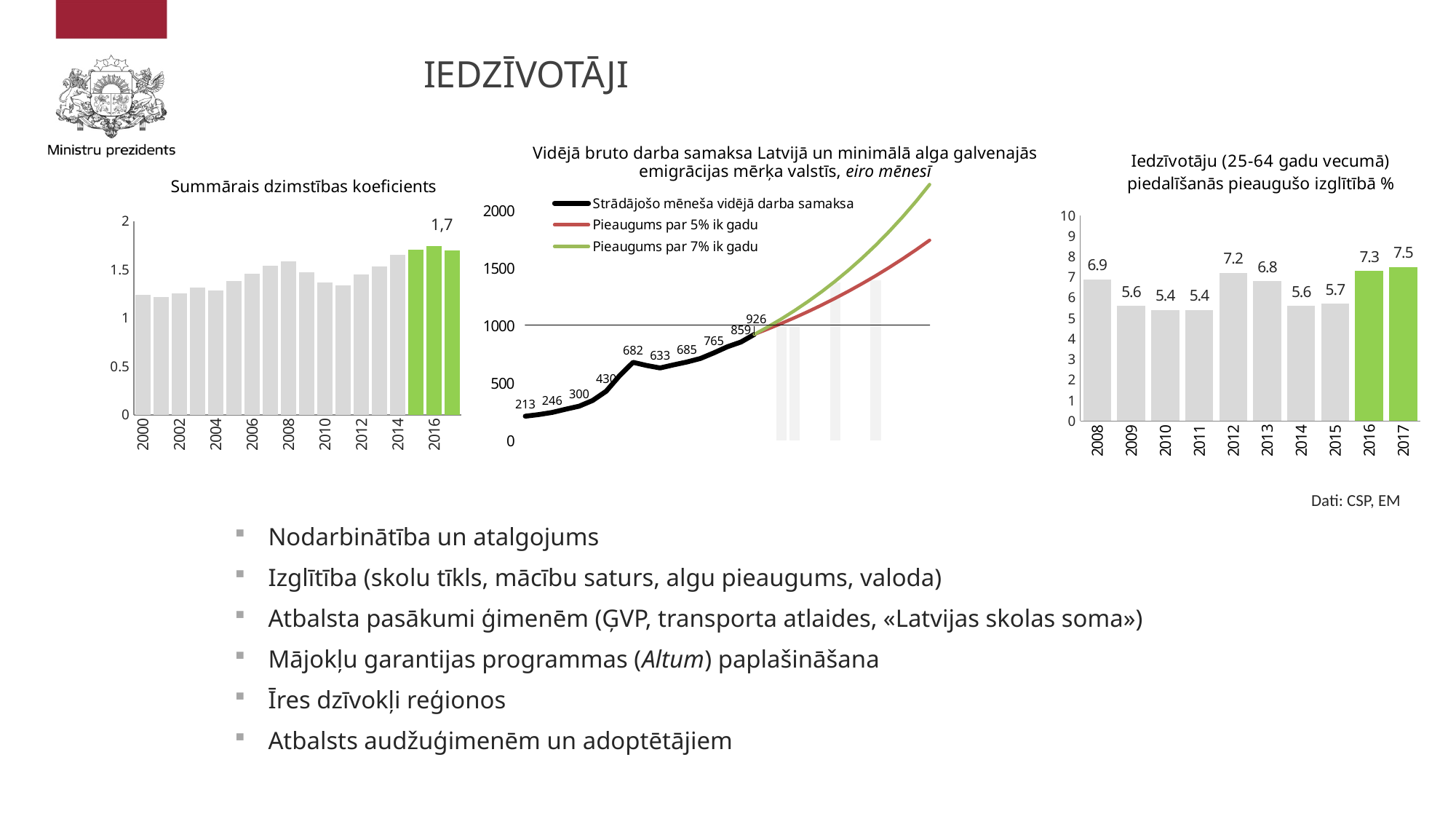
In the chart 'Iedzīvotāju (25-64 gadu vecumā) piedalīšanās pieaugušo izglītībā %', which year has the highest value? 2017 What kind of chart is 'Vidējā bruto darba samaksa Latvijā un minimālā alga galvenajās emigrācijas mērķa valstīs'? line chart In the chart 'Iedzīvotāju (25-64 gadu vecumā) piedalīšanās pieaugušo izglītībā %', what is the value for 2017? 7.5 How many series does the legend list in the chart 'Vidējā bruto darba samaksa Latvijā un minimālā alga galvenajās emigrācijas mērķa valstīs'? 3 In the chart 'Vidējā bruto darba samaksa Latvijā un minimālā alga galvenajās emigrācijas mērķa valstīs', what is the highest labelled value on the 'Strādājošo mēneša vidējā darba samaksa' line? 926 In the chart 'Iedzīvotāju (25-64 gadu vecumā) piedalīšanās pieaugušo izglītībā %', what is the value for 2008? 6.9 In the chart 'Iedzīvotāju (25-64 gadu vecumā) piedalīšanās pieaugušo izglītībā %', which is larger, the value for 2012 or for 2013? 2012 In the chart 'Iedzīvotāju (25-64 gadu vecumā) piedalīšanās pieaugušo izglītībā %', what is the difference between the values for 2017 and 2008? 0.6 In the chart 'Summārais dzimstības koeficients', is the value for 2000 greater or less than 1.5? less In the chart 'Vidējā bruto darba samaksa Latvijā un minimālā alga galvenajās emigrācijas mērķa valstīs', what is the difference between the last two labelled values on the black line, 926 and 859? 67 How many years are shown in the chart 'Iedzīvotāju (25-64 gadu vecumā) piedalīšanās pieaugušo izglītībā %'? 10 In the chart 'Summārais dzimstības koeficients', what value is labelled for 2016? 1,7